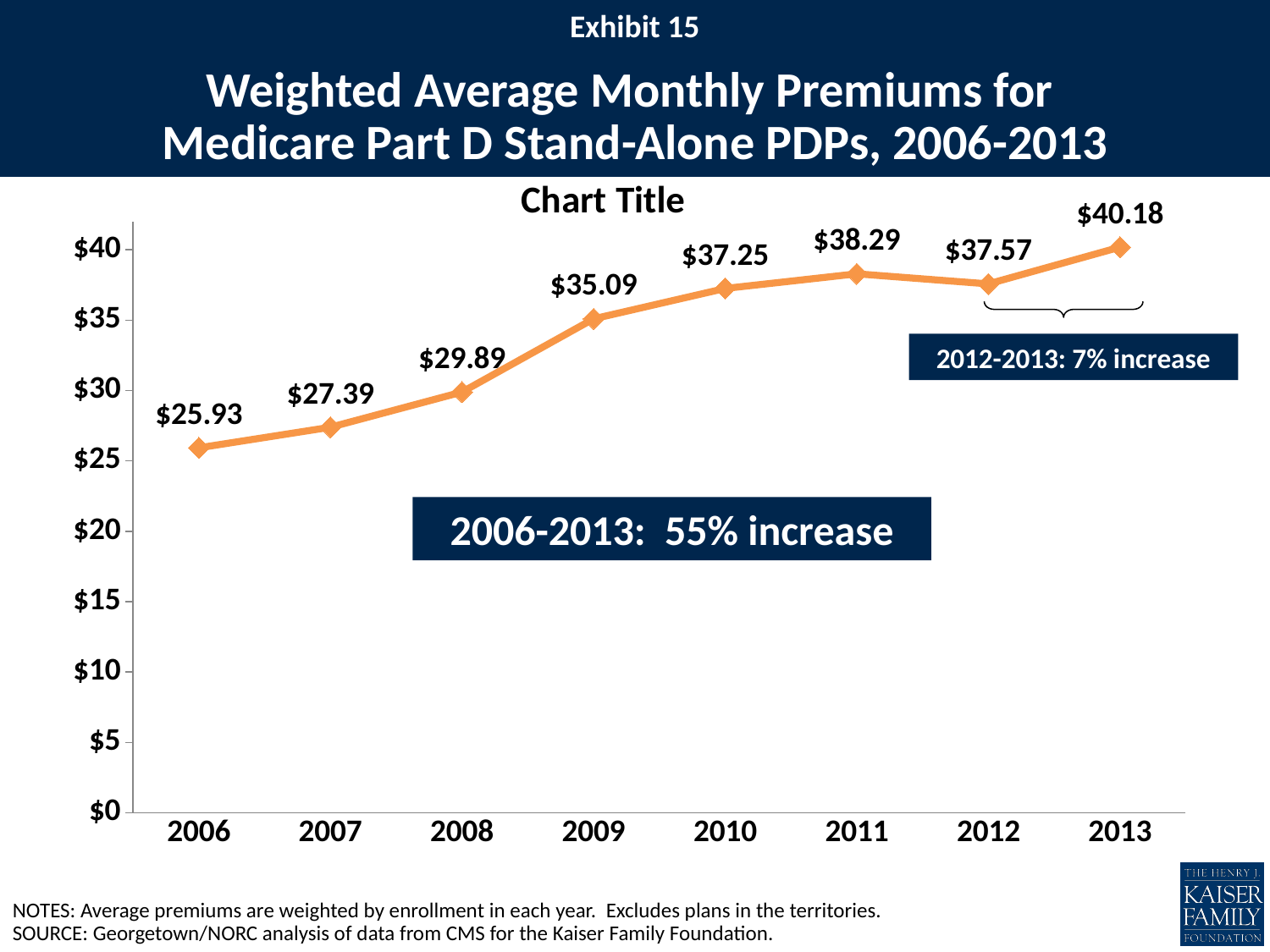
What is the difference between the 2013 premium and the 2006 premium? $14.25 Which year has the lowest weighted average monthly premium? 2006 What was the weighted average monthly premium in 2009? $35.09 What kind of chart is shown on the slide? Line chart What was the weighted average monthly premium in 2012? $37.57 What was the weighted average monthly premium in 2006? $25.93 What percentage increase does the chart annotation give for 2006-2013? 55% increase What is the difference between the 2011 premium and the 2012 premium? $0.72 How many years are plotted on the chart? 8 Is the value for 2010 greater or less than $35? greater Which year had a higher premium, 2011 or 2012? 2011 Which year has the highest weighted average monthly premium? 2013